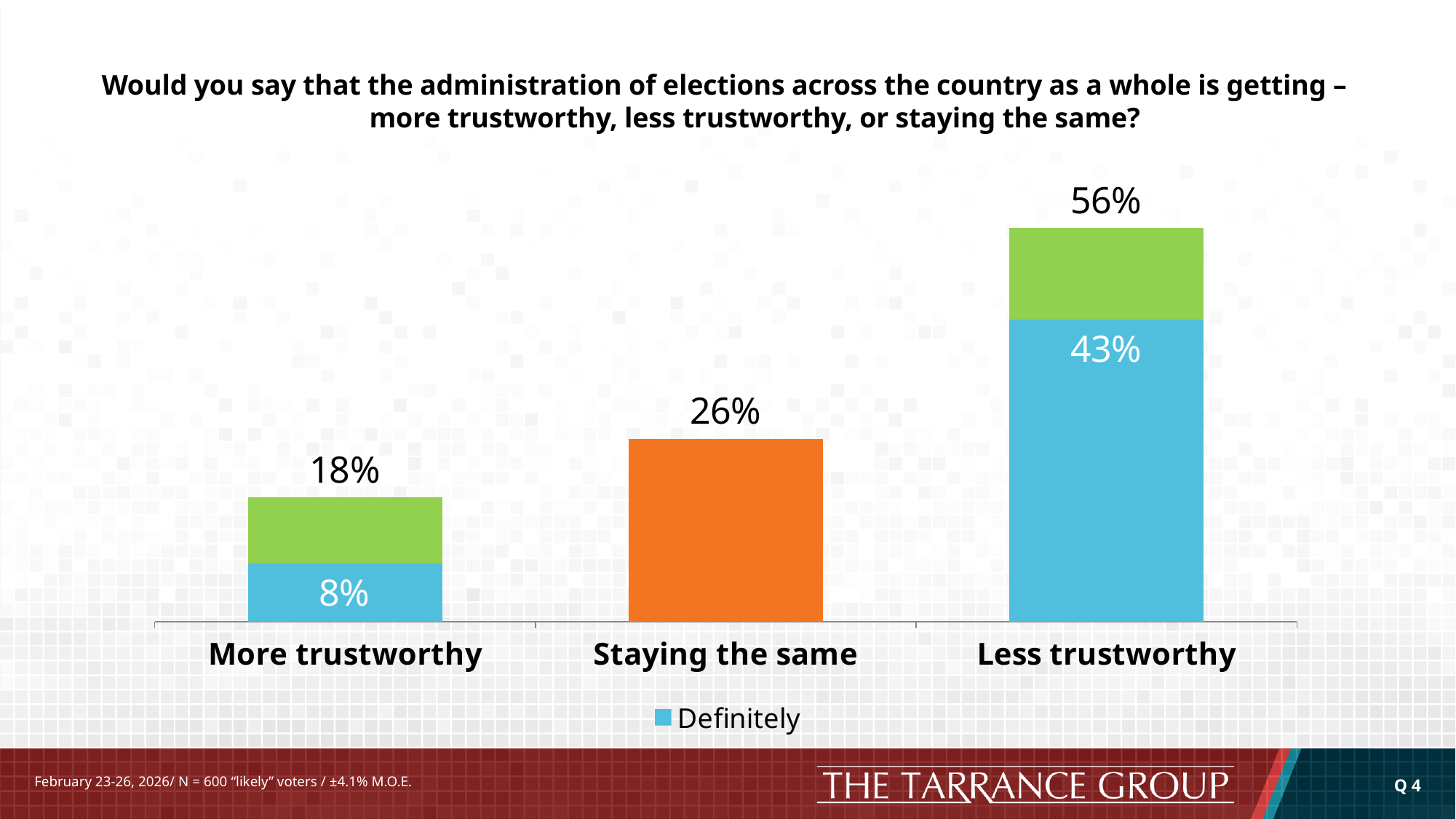
What is the difference between the total for Less trustworthy and the total for More trustworthy? 38% Which category has the highest total value? Less trustworthy How many categories are shown on the x axis? 3 What is the total value shown for Less trustworthy? 56% What is the value shown for Staying the same? 26% Which is larger, the value for Staying the same or the total for More trustworthy? Staying the same What is the Definitely value for More trustworthy? 8% Which category has the lowest total value? More trustworthy What entry does the legend list? Definitely What is the Definitely value for Less trustworthy? 43% What is the total value shown for More trustworthy? 18% What kind of chart is shown on the slide? Bar chart